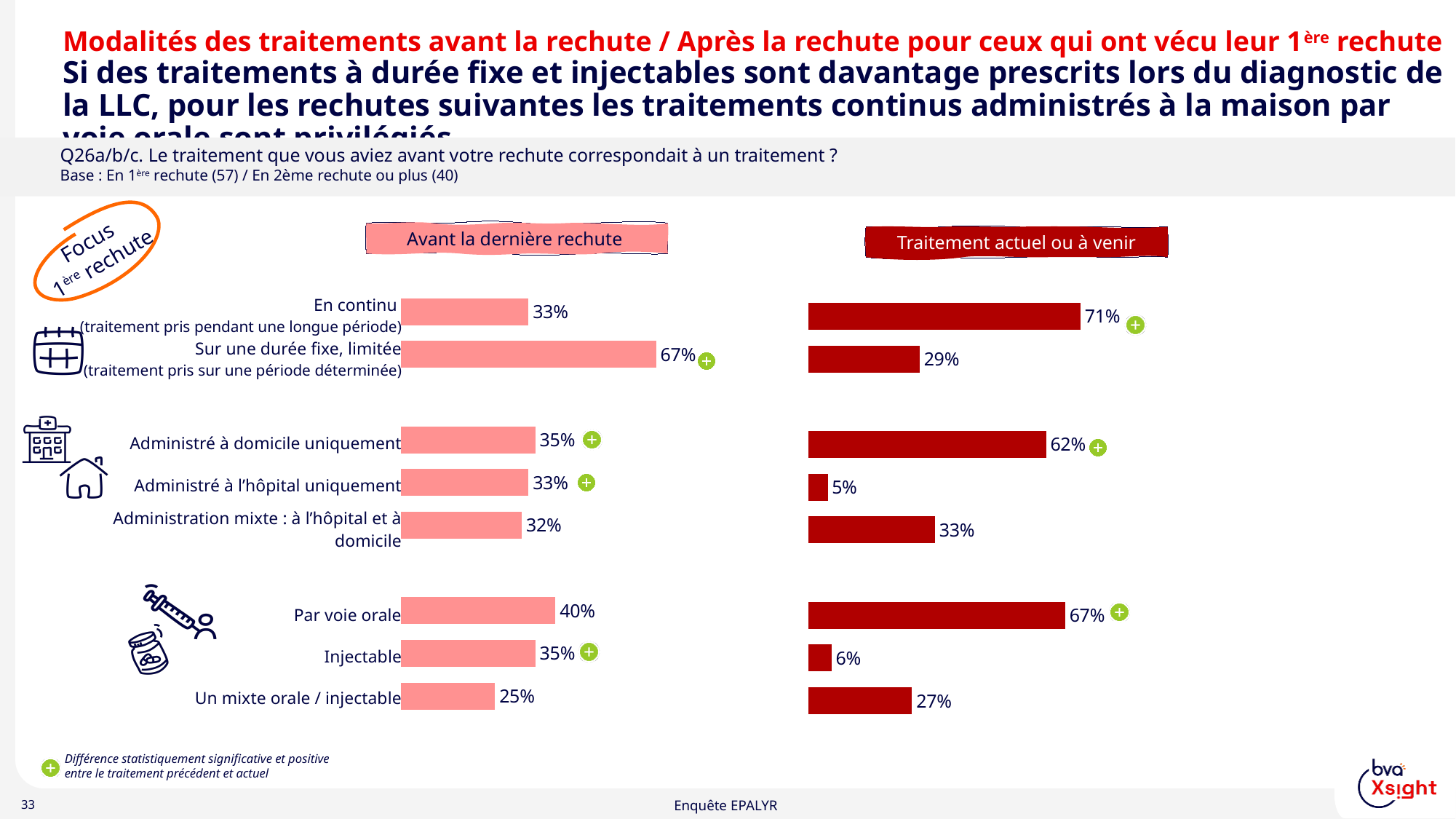
In the 'Traitement actuel ou à venir' chart, what is the value for 'En continu'? 71% In the 'Avant la dernière rechute' chart, what is the value for 'Par voie orale'? 40% What is the difference between the 'Traitement actuel ou à venir' value and the 'Avant la dernière rechute' value for 'En continu'? 38 percentage points For 'Administré à domicile uniquement', which chart shows the larger value: 'Avant la dernière rechute' or 'Traitement actuel ou à venir'? Traitement actuel ou à venir In the 'Traitement actuel ou à venir' chart, which category has the lowest value? Administré à l'hôpital uniquement In the 'Traitement actuel ou à venir' chart, which category has the highest value? En continu In the 'Traitement actuel ou à venir' chart, what is the value for 'Injectable'? 6% In the 'Avant la dernière rechute' chart, which category has the lowest value? Un mixte orale / injectable How many categories are plotted in the 'Avant la dernière rechute' chart? 8 In the 'Avant la dernière rechute' chart, what is the value for 'Sur une durée fixe, limitée'? 67% What colour are the bars in the 'Traitement actuel ou à venir' chart? Dark red What type of chart is used on this slide? Bar chart